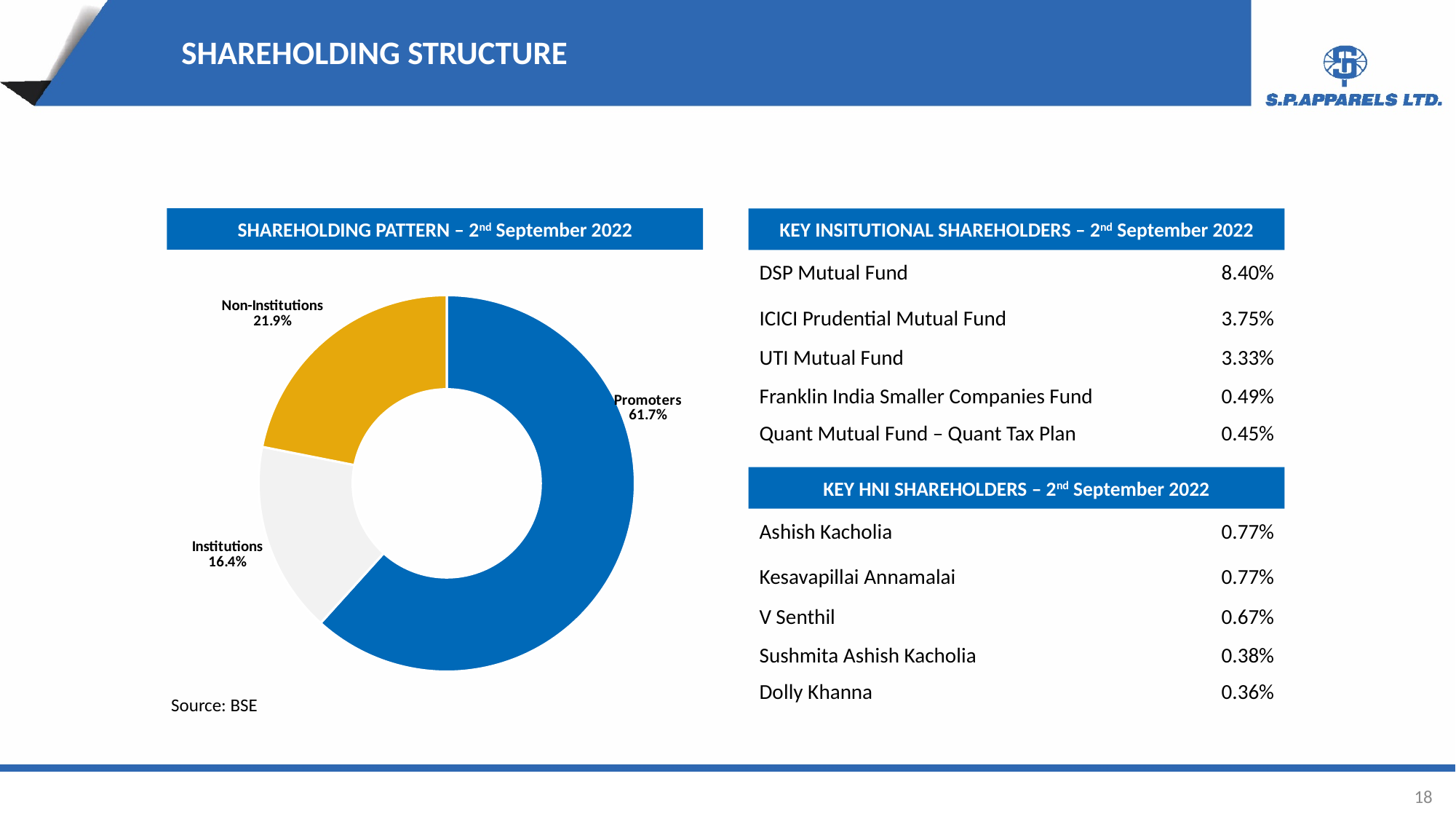
What share of shareholding do Non-Institutions hold in the Shareholding Pattern chart? 21.9% Is the Promoters share in the Shareholding Pattern chart greater or less than 50%? greater What share of shareholding do Institutions hold in the Shareholding Pattern chart? 16.4% What colour is the Promoters slice in the Shareholding Pattern chart? Blue Which category holds the smallest share in the Shareholding Pattern chart? Institutions By how many percentage points does the Promoters share exceed the Non-Institutions share in the Shareholding Pattern chart? 39.8 percentage points In the Shareholding Pattern chart, which is larger: the Institutions share or the Non-Institutions share? Non-Institutions What share of shareholding do Promoters hold in the Shareholding Pattern chart? 61.7% What is the difference between the Non-Institutions share and the Institutions share in the Shareholding Pattern chart? 5.5 percentage points Which category holds the largest share in the Shareholding Pattern chart? Promoters How many categories are shown in the Shareholding Pattern chart? 3 What kind of chart is the Shareholding Pattern chart? Doughnut chart